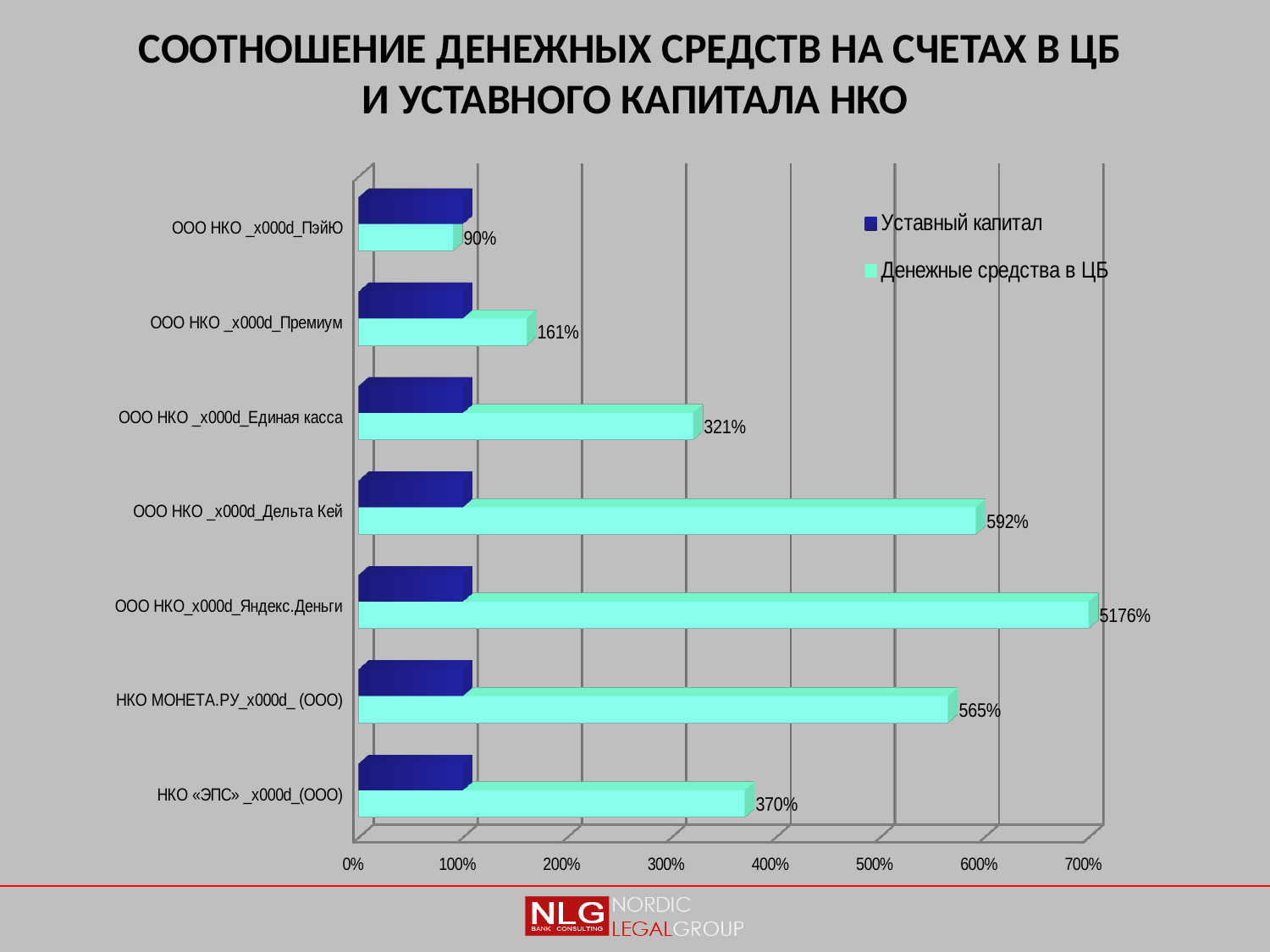
What kind of chart is shown on the slide? bar chart Is the Уставный капитал value for ООО НКО Пэйю greater or less than 200%? less How many series does the legend list? 2 Which is larger, the Денежные средства в ЦБ value for ООО НКО Премиум or for ООО НКО Единая касса? ООО НКО Единая касса How many categories (organisations) are shown on the chart? 7 Which category has the lowest value for Денежные средства в ЦБ? ООО НКО Пэйю What is the value of Денежные средства в ЦБ for ООО НКО Единая касса? 321% What is the value of Денежные средства в ЦБ for НКО «ЭПС» (ООО)? 370% Which series is shown in dark blue according to the legend? Уставный капитал What is the value of Денежные средства в ЦБ for ООО НКО Пэйю? 90% What is the difference between the Денежные средства в ЦБ values for ООО НКО Дельта Кей and НКО МОНЕТА.РУ (ООО)? 27 percentage points Which category has the highest labelled value for Денежные средства в ЦБ? ООО НКО Яндекс.Деньги